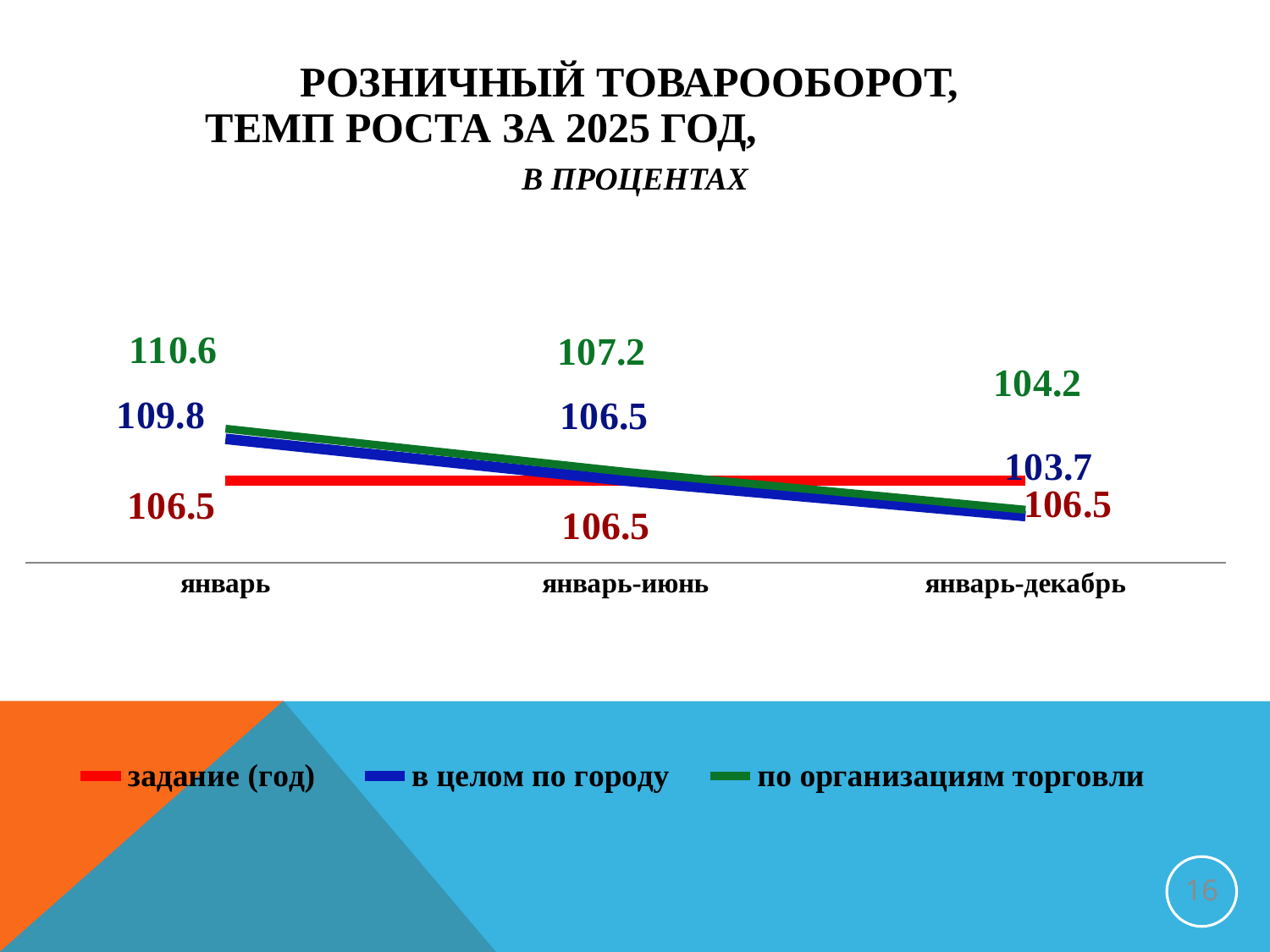
In which period is the value for "в целом по городу" lowest? январь-декабрь What is the value for "в целом по городу" in январь? 109.8 In which period is the value for "по организациям торговли" highest? январь How many series does the legend list? 3 Do the values for "в целом по городу" rise or fall from январь to январь-декабрь? fall What is the difference between "по организациям торговли" and "в целом по городу" in январь-декабрь? 0.5 Which is larger in январь: "по организациям торговли" or "задание (год)"? по организациям торговли What is the value for "по организациям торговли" in январь? 110.6 How many periods are shown on the x axis? 3 What is the value for "в целом по городу" in январь-декабрь? 103.7 What is the value of "задание (год)" in январь-июнь? 106.5 What kind of chart is shown on the slide? line chart